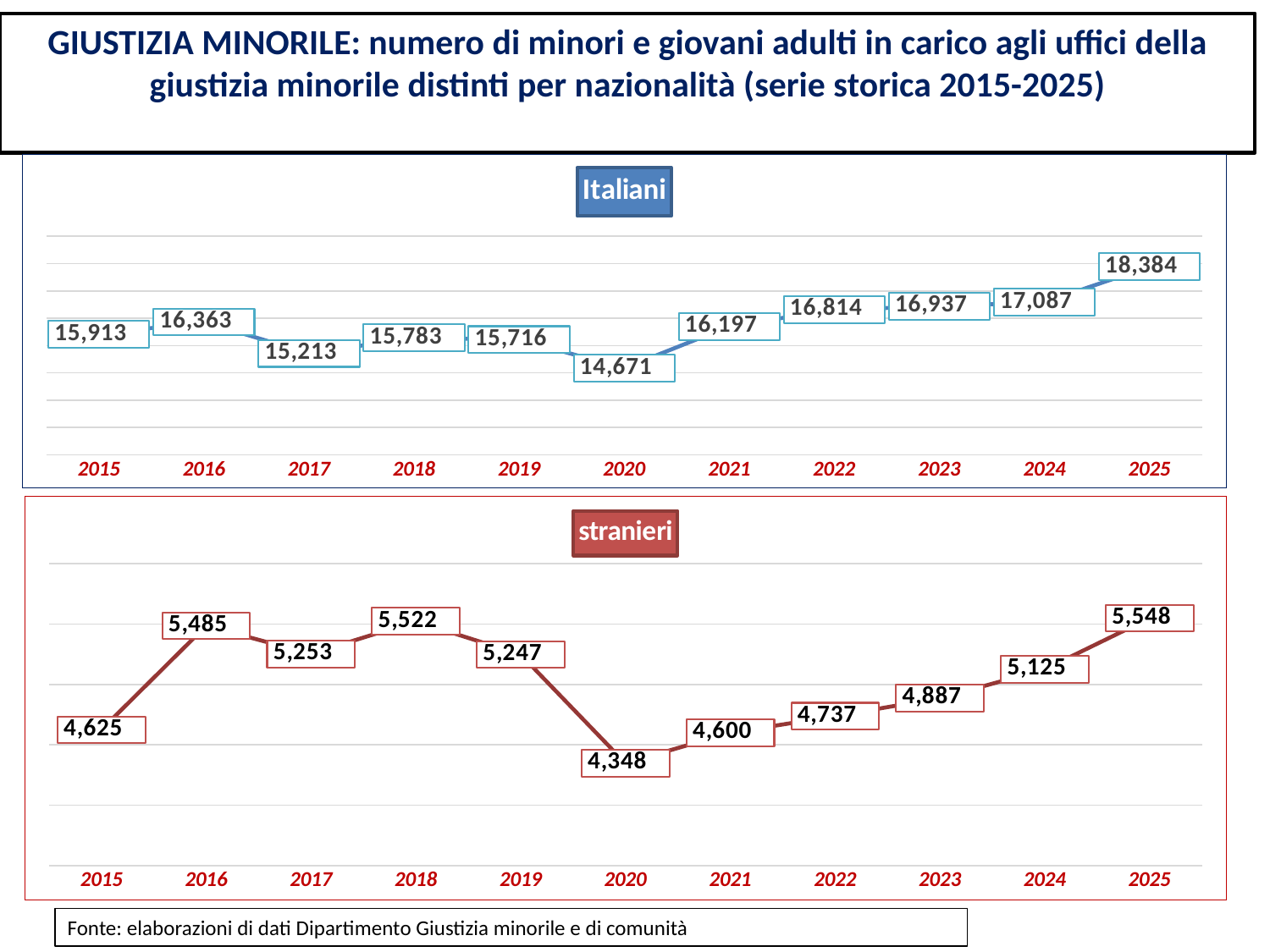
What type of chart is the 'stranieri' chart? Line chart In the 'stranieri' chart, which year has the highest value? 2025 In the 'Italiani' chart, which year has the highest value? 2025 In the 'stranieri' chart, which year has the lowest value? 2020 In the 'stranieri' chart, what is the difference between the 2018 value and the 2020 value? 1,174 In the 'Italiani' chart, which year has the lowest value? 2020 In the 'Italiani' chart, what is the value for 2025? 18,384 How many years are plotted in the 'Italiani' chart? 11 In the 'Italiani' chart, what is the value for 2020? 14,671 In the 'stranieri' chart, which is larger, the value for 2016 or the value for 2019? 2016 In the 'Italiani' chart, what is the difference between the 2025 value and the 2015 value? 2,471 In the 'stranieri' chart, what is the value for 2021? 4,600